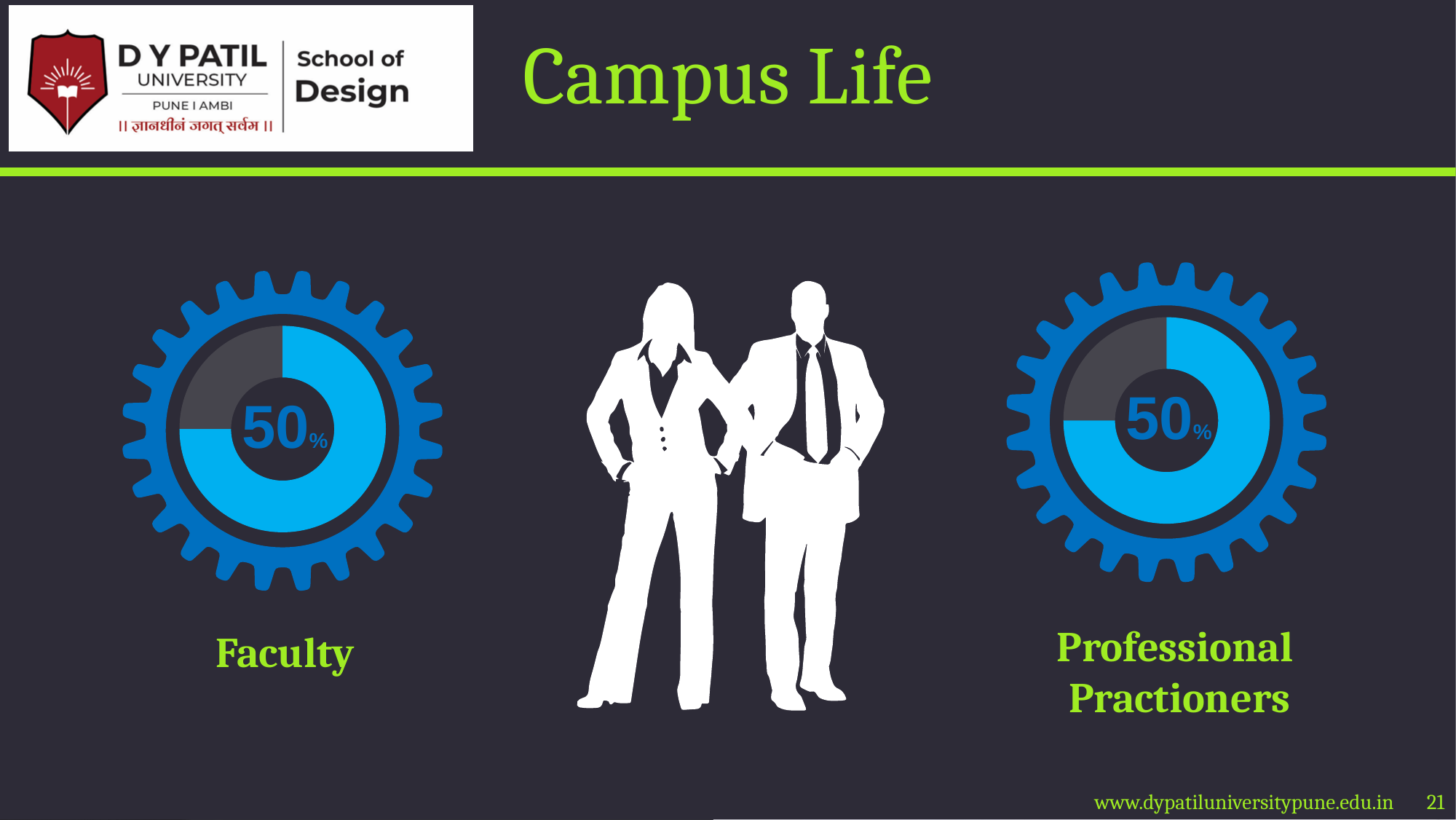
What percentage is shown in the Professional Practioners chart? 50% How many donut charts are on the slide? 2 Is the value shown in the Faculty chart greater or less than 40%? greater What is the title of the slide containing the two donut charts? Campus Life What percentage is shown in the Faculty chart? 50% What kind of chart is used to show the Faculty percentage? Donut (pie) chart Which is larger, the percentage shown for Faculty or for Professional Practioners? They are equal (both 50%) What colour is the filled portion of the Professional Practioners donut chart? Blue